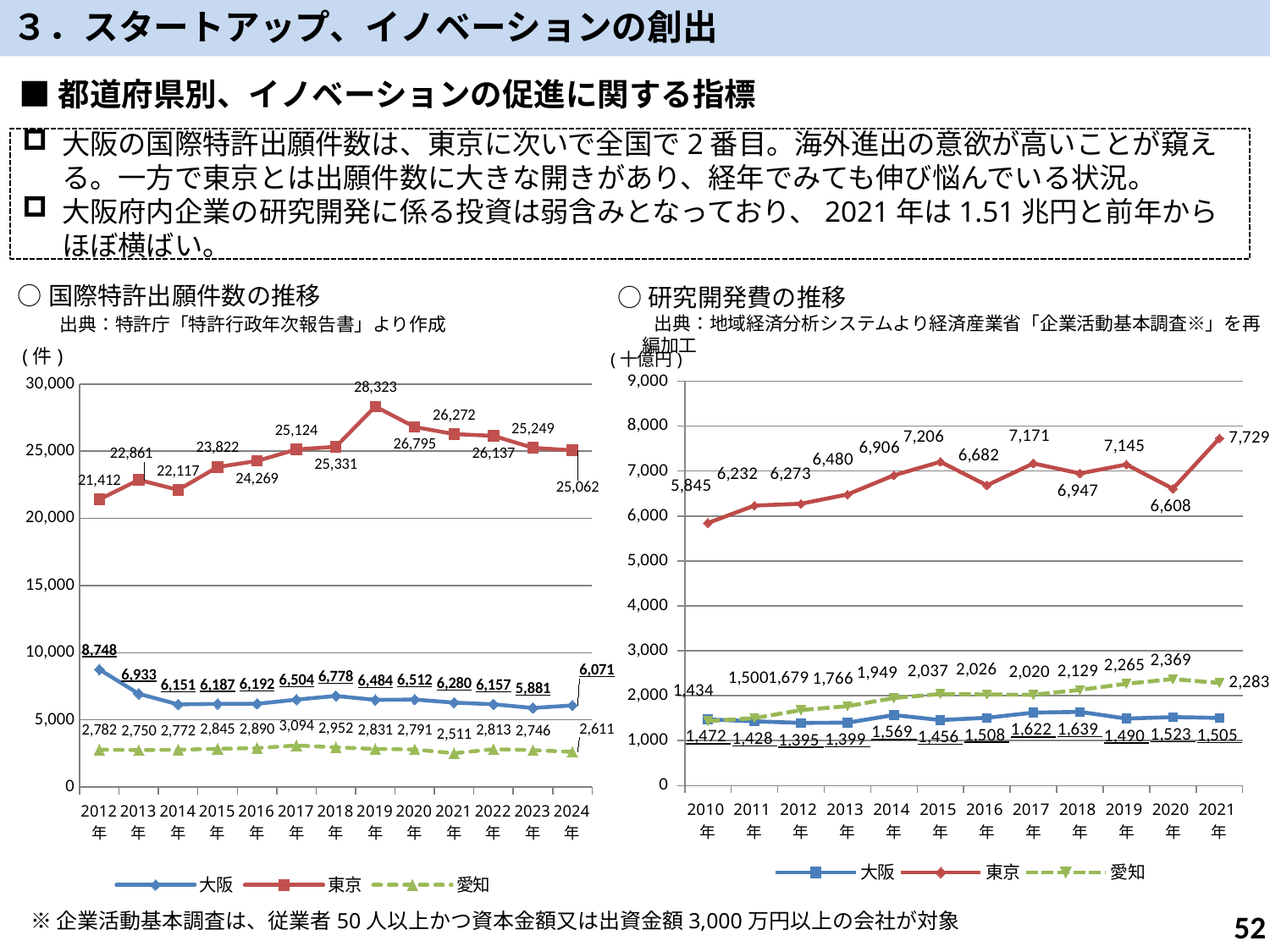
「研究開発費の推移」のグラフの凡例には、いくつの系列がありますか？ 3 「研究開発費の推移」のグラフはどの種類のグラフですか？ 折れ線グラフ 「国際特許出願件数の推移」のグラフで、東京の値が最も高いのは何年ですか？ 2019年 「研究開発費の推移」のグラフで、2021年の東京の値はいくつですか？ 7,729 「研究開発費の推移」のグラフで、2021年の大阪と愛知ではどちらの値が大きいですか？ 愛知 「国際特許出願件数の推移」のグラフには、何年分のデータ点がありますか？ 13 「国際特許出願件数の推移」のグラフで、2019年の東京の値はいくつですか？ 28,323 「国際特許出願件数の推移」のグラフで、2024年の東京と大阪の差はいくつですか？ 18,991 「国際特許出願件数の推移」のグラフで、2024年の大阪の値はいくつですか？ 6,071 「研究開発費の推移」のグラフで、2020年の愛知の値はいくつですか？ 2,369 「研究開発費の推移」のグラフで、2010年の東京の値は6,000より大きいですか、小さいですか？ 小さい 「国際特許出願件数の推移」のグラフで、大阪の値が最も低いのは何年ですか？ 2023年